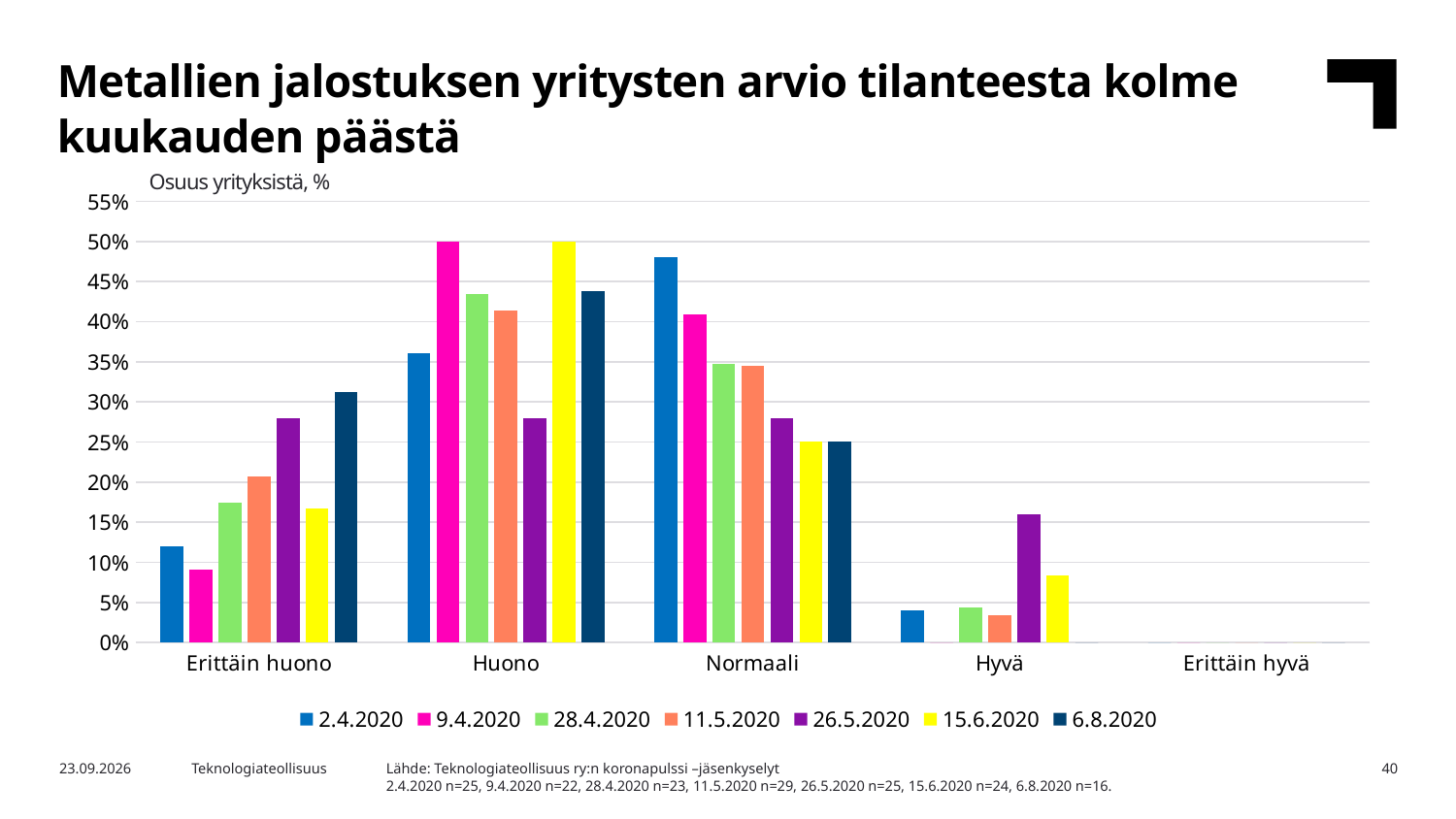
In the Erittäin huono category, which series has the highest value? 6.8.2020 Is the value for 2.4.2020 in the Normaali category greater or less than 45%? greater Is the value for 6.8.2020 in the Erittäin huono category greater or less than 25%? greater What is the value for 15.6.2020 in the Normaali category? 25% What is the label on the vertical axis of the chart? Osuus yrityksistä, % What is the value for 9.4.2020 in the Huono category? 50% For the 9.4.2020 series, which is larger: the value for Huono or the value for Normaali? Huono How many categories are shown on the x axis? 5 Is the value for 2.4.2020 in the Erittäin huono category greater or less than 15%? less How many series does the legend list? 7 What kind of chart is shown on the slide? bar chart